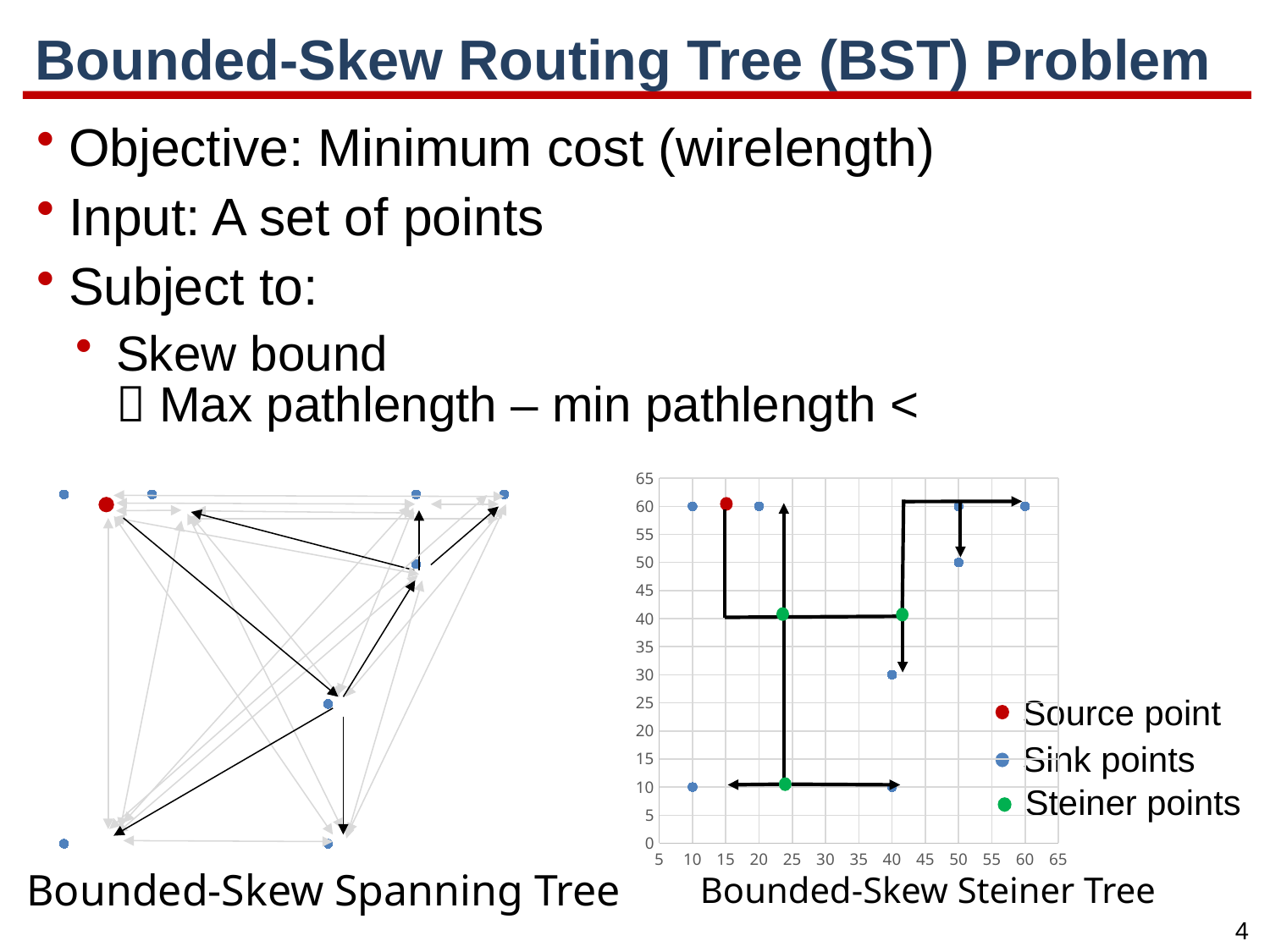
In the Bounded-Skew Steiner Tree chart, what is the y-value of the sink point at x = 60? 60 In the Bounded-Skew Steiner Tree chart, how many series does the legend list? 3 In the Bounded-Skew Steiner Tree chart, what colour are the Steiner points? green In the Bounded-Skew Steiner Tree chart, what are the three legend entries? Source point, Sink points, Steiner points In the Bounded-Skew Steiner Tree chart, what kind of chart is used to plot the points? scatter chart In the Bounded-Skew Steiner Tree chart, how many Steiner points are plotted? 3 In the Bounded-Skew Steiner Tree chart, what is the highest value shown on the y axis? 65 In the Bounded-Skew Steiner Tree chart, how many source points are plotted? 1 In the Bounded-Skew Steiner Tree chart, what is the y-value of the source point? 60 In the Bounded-Skew Steiner Tree chart, what is the x-value of the source point? 15 What is the caption of the chart on the left side of the slide? Bounded-Skew Spanning Tree In the Bounded-Skew Steiner Tree chart, is the y-value of the lower sink point at x = 50 greater or less than 45? greater